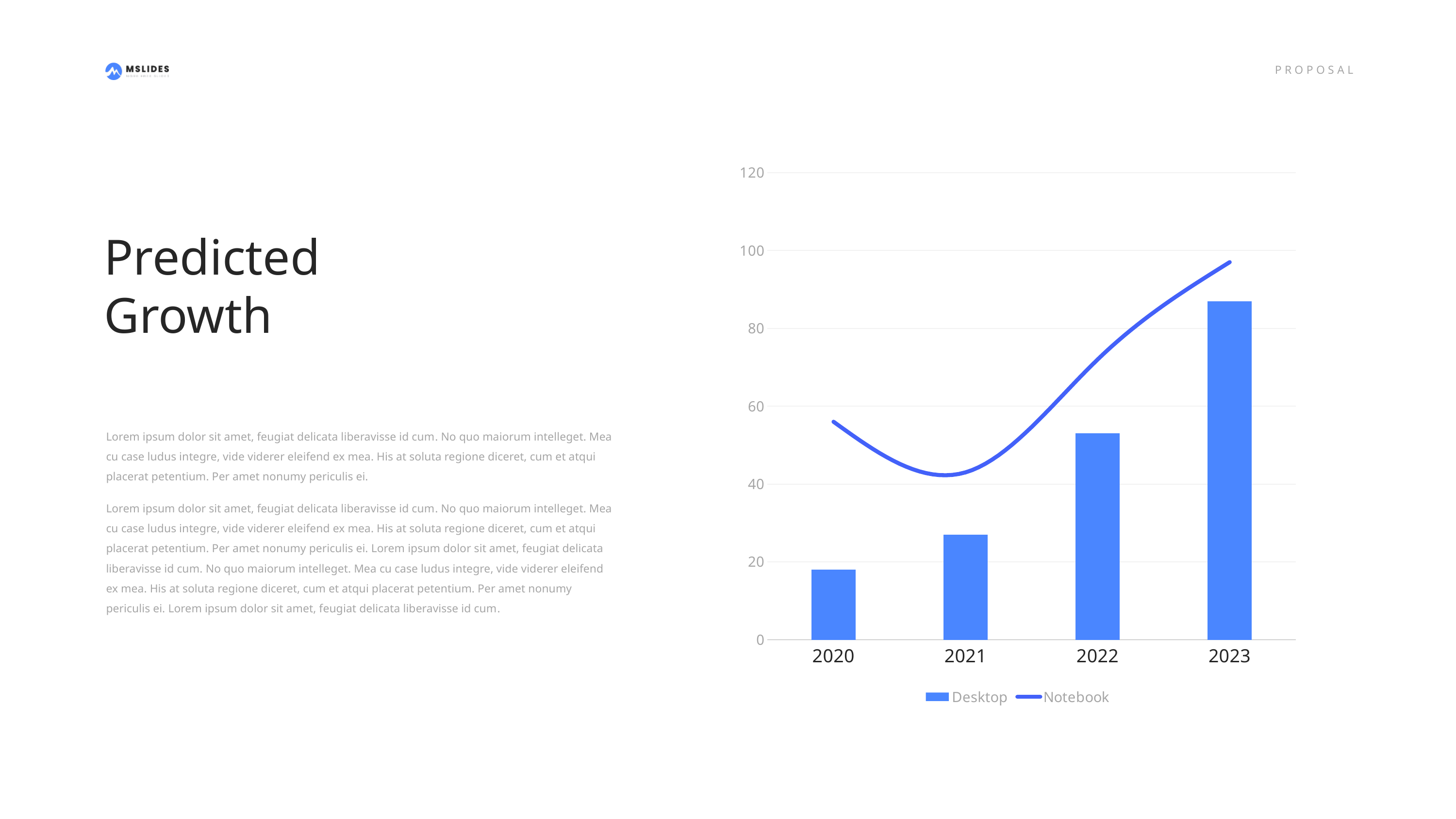
What is the highest value shown on the chart's vertical axis? 120 Which series is drawn as a line in the chart? Notebook Which year has the lowest Desktop bar? 2020 Do the Desktop bars rise or fall from 2020 to 2023? rise How many years are shown on the x axis of the chart? 4 Is the Desktop value for 2023 greater or less than 80? greater Which year has the highest Desktop bar? 2023 How many series does the chart legend list? 2 Is the Notebook value for 2023 greater or less than 80? greater Which is larger in 2022, the Desktop value or the Notebook value? Notebook Is the Notebook value for 2021 greater or less than 60? less